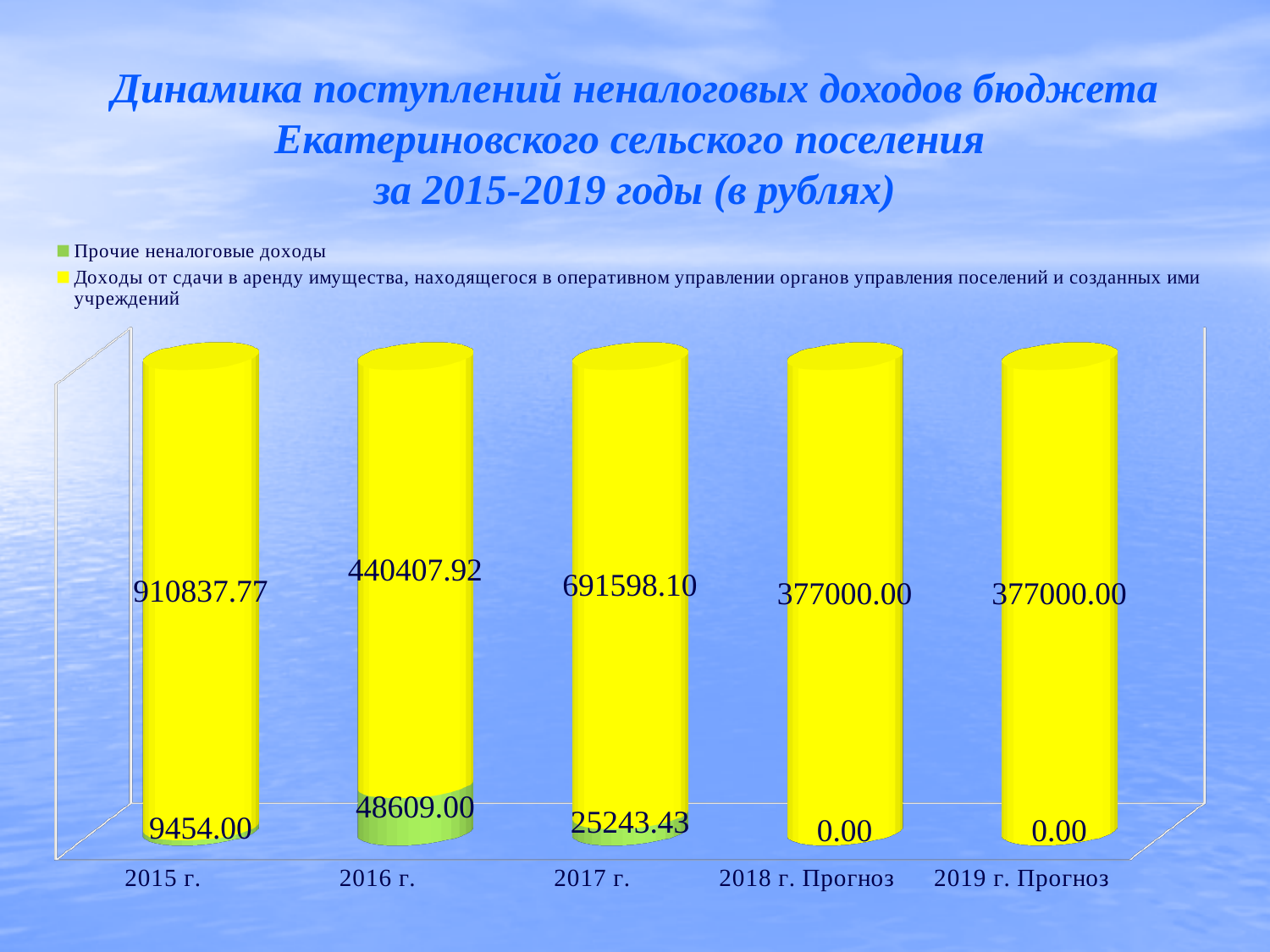
What is the difference between the 'Доходы от сдачи в аренду имущества...' values for 2015 г. and 2016 г.? 470429.85 How many categories (years) are shown on the x axis? 5 What is the value of 'Доходы от сдачи в аренду имущества...' for 2015 г.? 910837.77 What is the value of 'Прочие неналоговые доходы' for 2017 г.? 25243.43 How many series does the legend list? 2 Which year has the lowest value for 'Прочие неналоговые доходы' among 2015 г., 2016 г. and 2017 г.? 2015 г. What is the value of 'Прочие неналоговые доходы' for 2016 г.? 48609.00 What is the value of 'Доходы от сдачи в аренду имущества...' for 2019 г. Прогноз? 377000.00 What is the total of the stacked bar for 2016 г.? 489016.92 Which is larger: 'Доходы от сдачи в аренду имущества...' for 2017 г. or for 2018 г. Прогноз? 2017 г. Which year has the highest value for 'Прочие неналоговые доходы'? 2016 г. Which year has the highest value for 'Доходы от сдачи в аренду имущества...'? 2015 г.